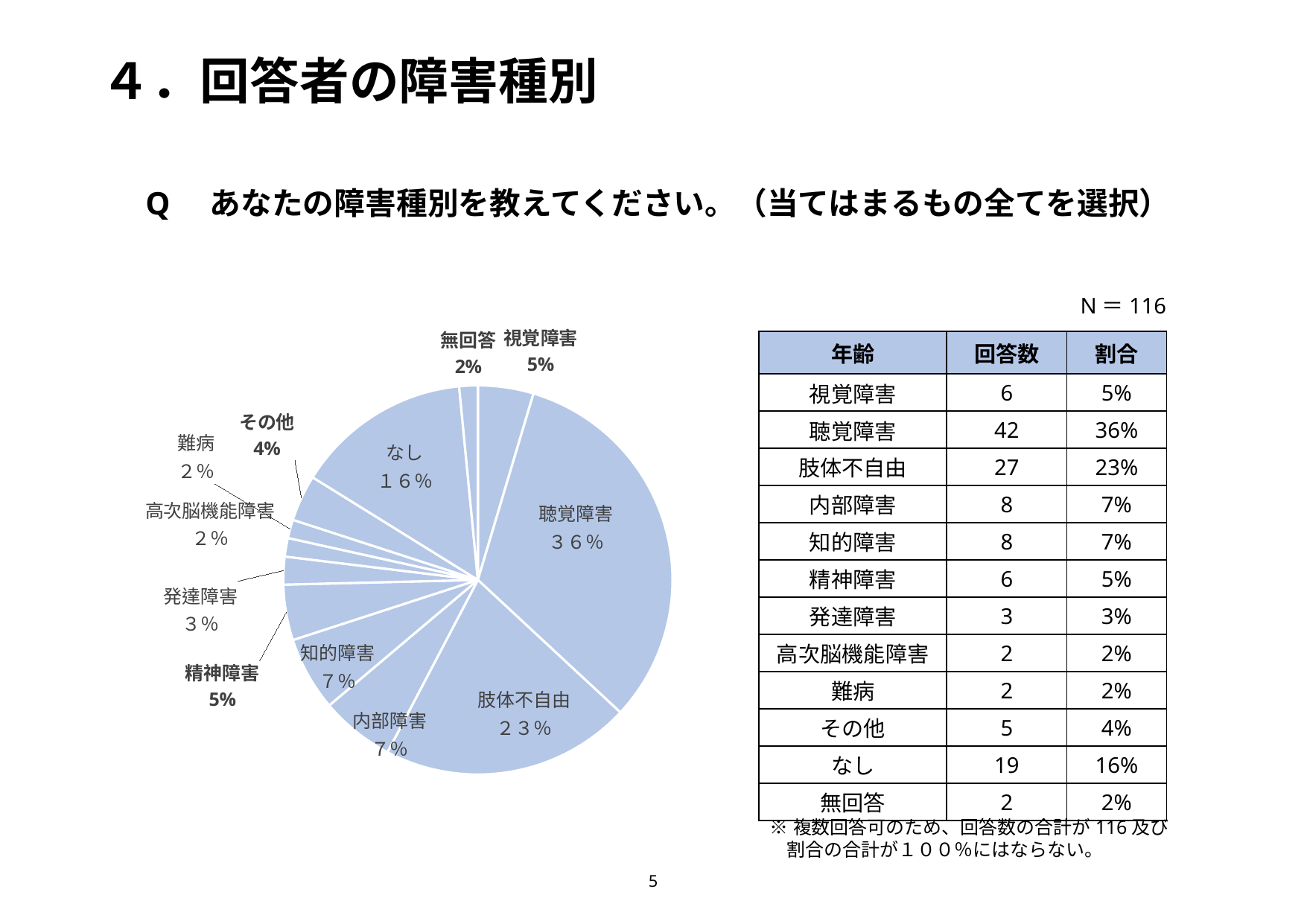
What percentage does the pie chart show for なし? 16% What percentage does the pie chart show for 発達障害? 3% Which category has the largest slice in the pie chart? 聴覚障害 Which is larger in the pie chart, 肢体不自由 or なし? 肢体不自由 What is the value of N shown above the table on the slide? 116 What percentage does the pie chart show for 聴覚障害? 36% How many slices does the pie chart have? 12 What percentage does the pie chart show for その他? 4% What share of the pie does 内部障害 represent? 7% What is the difference in percentage points between 聴覚障害 and 肢体不自由 in the pie chart? 13 What kind of chart is shown on the slide? pie chart What percentage does the pie chart show for 肢体不自由? 23%